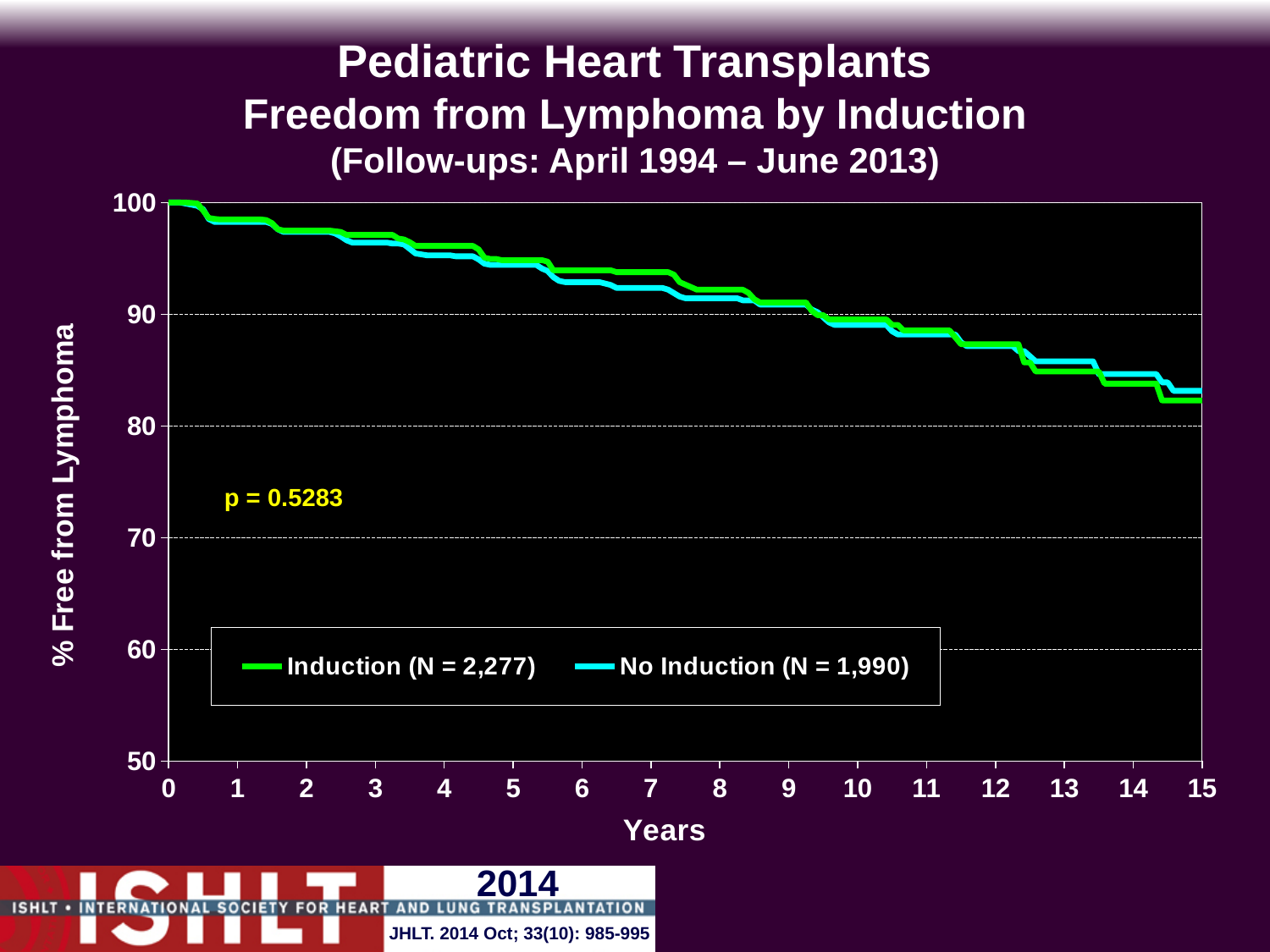
Is the value for the No Induction series at year 15 greater or less than 80? greater Is the value for the Induction series at year 12 greater or less than 90? less What is the value for the Induction series at year 0? 100 What are the two series named in the legend? Induction (N = 2,277) and No Induction (N = 1,990) What is the p-value printed on the chart? p = 0.5283 Do the values for the No Induction series rise or fall as years increase? fall How many series does the legend list? 2 Do the values for the Induction series rise or fall as years increase? fall How many year tick marks are labelled on the x axis? 16 Is the value for the Induction series at year 15 greater or less than 90? less What kind of chart is shown on the slide? line chart